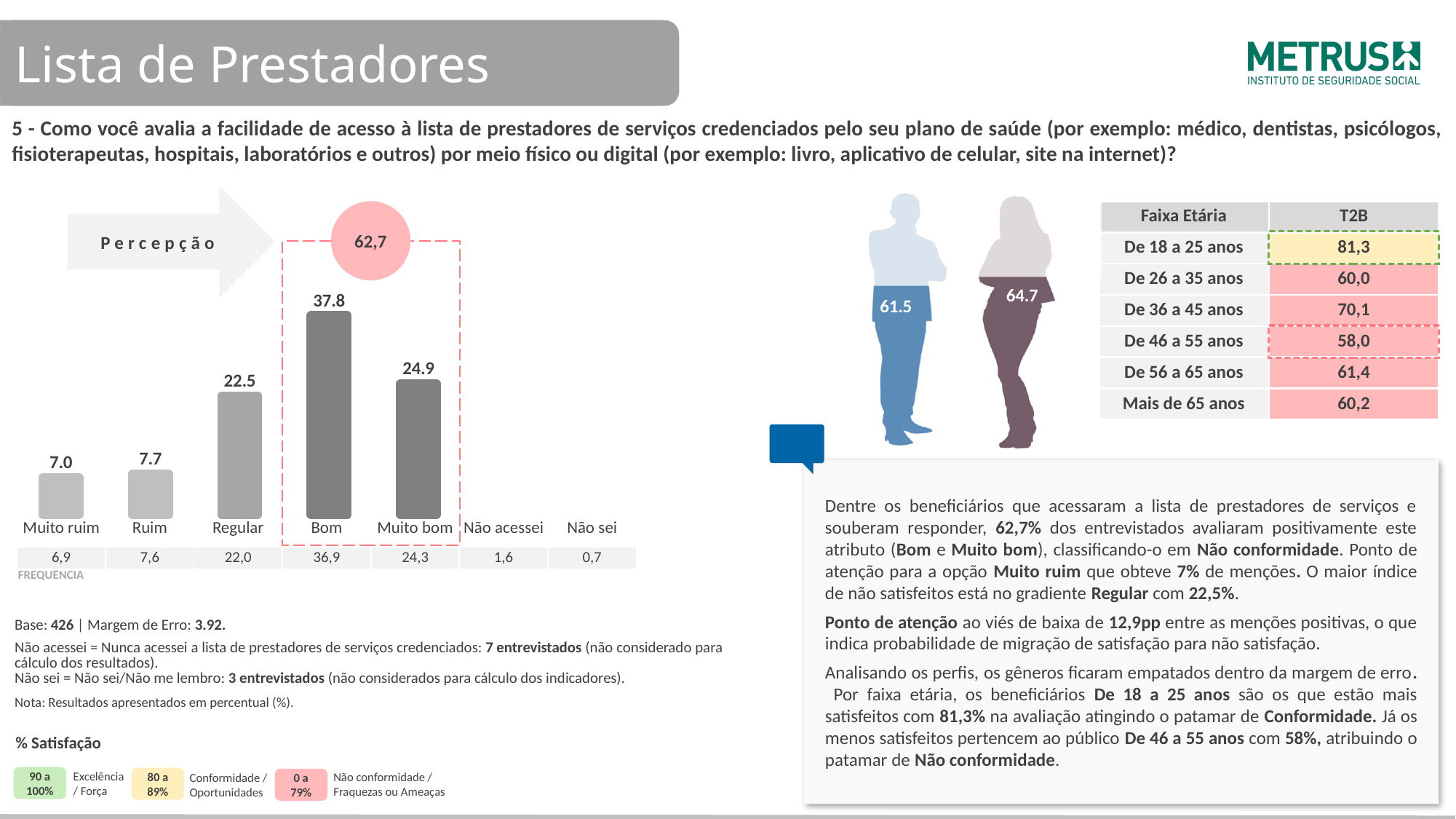
In the Percepção bar chart, which is larger, Muito bom or Regular? Muito bom In the Percepção bar chart, what is the difference between the Regular and Ruim values? 14.8 How many bars are plotted in the Percepção bar chart? 5 Which category has the highest bar in the Percepção bar chart? Bom What is the value of the Muito ruim bar in the Percepção bar chart? 7.0 In the Percepção bar chart, what is the difference between the Bom and Muito bom values? 12.9 What value is shown in the pink circle above the Bom and Muito bom bars in the Percepção chart? 62,7 What is the value of the Regular bar in the Percepção bar chart? 22.5 Which category has the lowest bar in the Percepção bar chart? Muito ruim What is the value of the Bom bar in the Percepção bar chart? 37.8 In the Percepção bar chart, what is the combined value of the Bom and Muito bom bars? 62.7 What kind of chart is the Percepção chart? bar chart